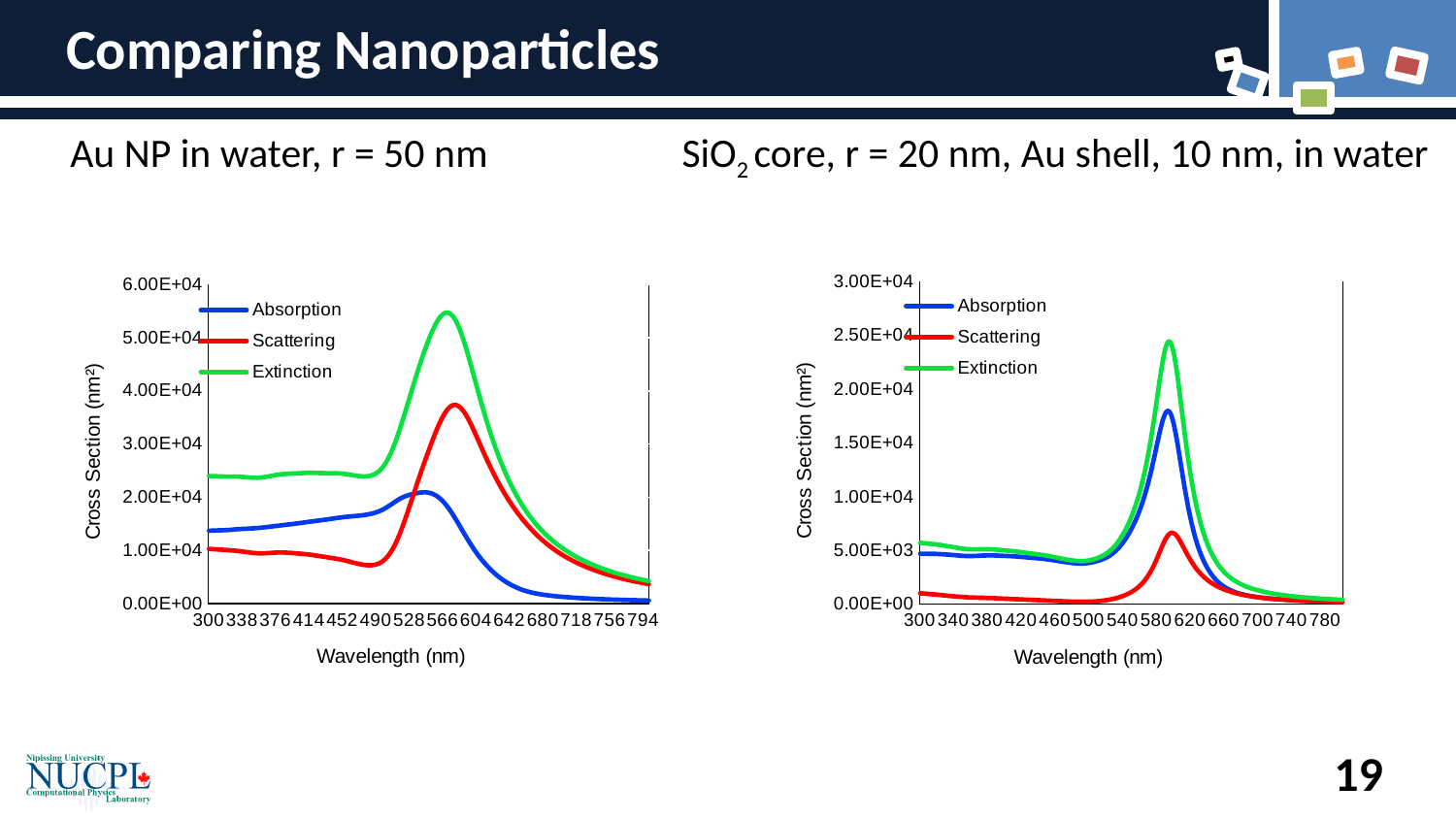
In the right chart, 'SiO2 core, r = 20 nm, Au shell, 10 nm, in water', which series has the larger peak: Absorption or Scattering? Absorption In the left chart, 'Au NP in water, r = 50 nm', which series reaches the highest peak value? Extinction In the left chart, 'Au NP in water, r = 50 nm', is the peak value of the Extinction series greater or less than 5.00E+04? greater In the left chart, 'Au NP in water, r = 50 nm', does the Absorption series rise or fall between 604 nm and 794 nm? fall In the right chart, 'SiO2 core, r = 20 nm, Au shell, 10 nm, in water', is the peak value of the Absorption series greater or less than 1.50E+04? greater What kind of chart is the left chart, 'Au NP in water, r = 50 nm'? line chart In the left chart, 'Au NP in water, r = 50 nm', which series has the larger peak: Scattering or Absorption? Scattering What is the y-axis label of the left chart, 'Au NP in water, r = 50 nm'? Cross Section (nm²) How many series does the legend of the right chart, 'SiO2 core, r = 20 nm, Au shell, 10 nm, in water', list? 3 In the left chart, 'Au NP in water, r = 50 nm', is the peak value of the Scattering series greater or less than 3.00E+04? greater In the right chart, 'SiO2 core, r = 20 nm, Au shell, 10 nm, in water', which series has the lowest peak value? Scattering